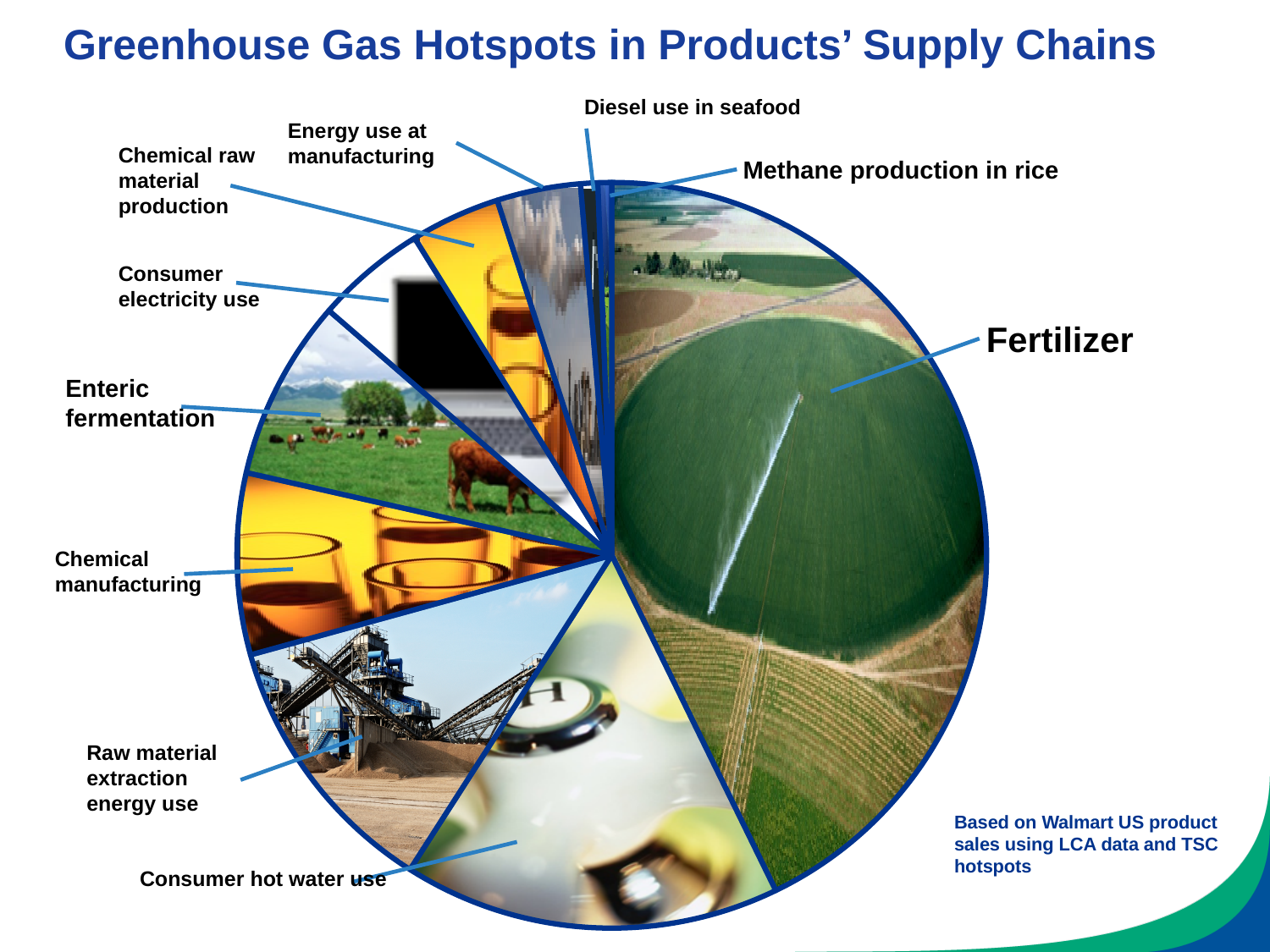
What is the title of the slide containing the pie chart? Greenhouse Gas Hotspots in Products' Supply Chains Which is larger, the slice for Consumer hot water use or the slice for Diesel use in seafood? Consumer hot water use Which is larger, the slice for Enteric fermentation or the slice for Methane production in rice? Enteric fermentation Which is larger, the slice for Fertilizer or the slice for Consumer hot water use? Fertilizer According to the note on the slide, what is the pie chart based on? Walmart US product sales using LCA data and TSC hotspots How many slices (categories) does the pie chart have? 10 Which category has the largest slice of the pie chart? Fertilizer What kind of chart is shown on the slide? pie chart